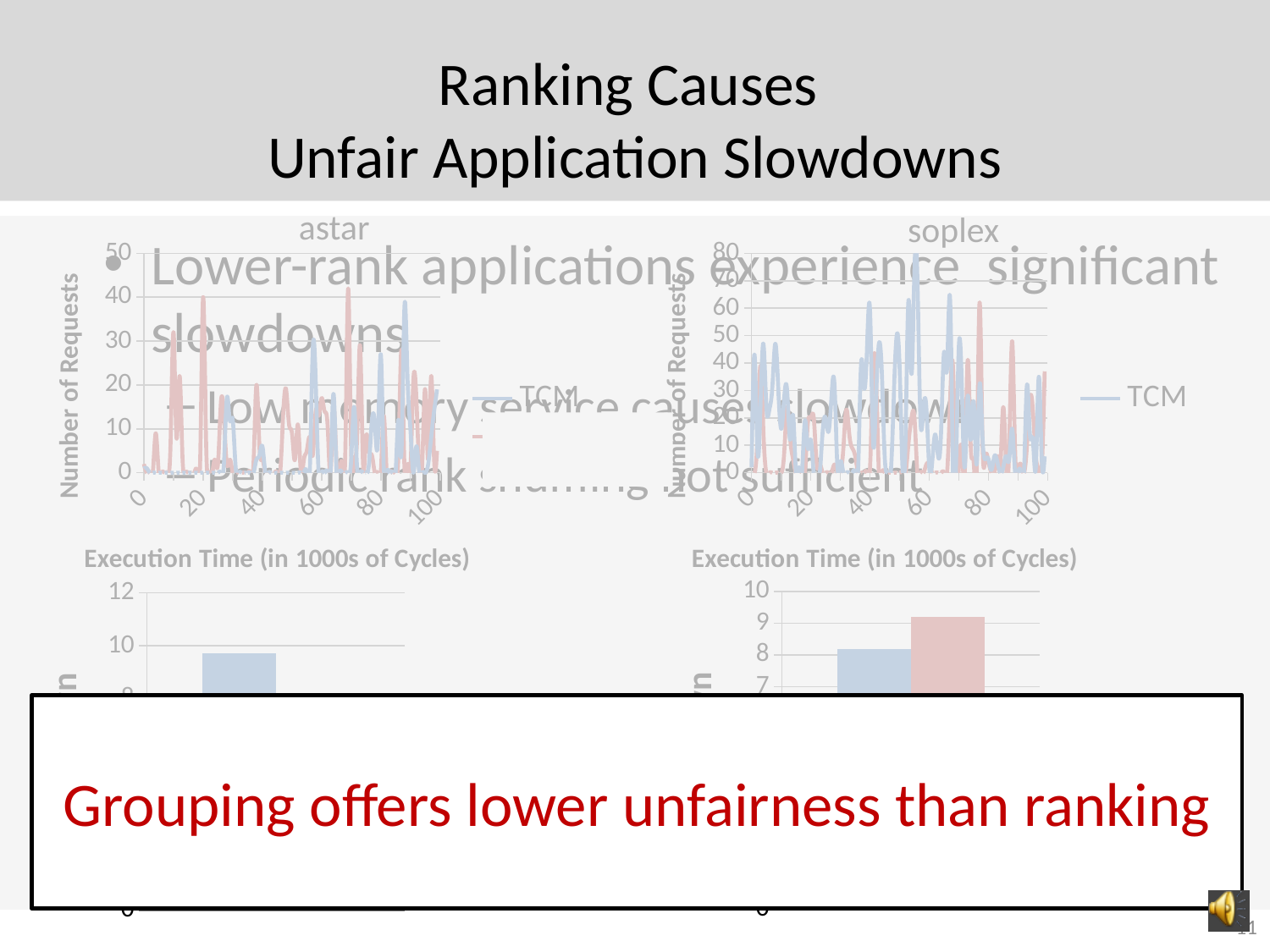
What is the y-axis title of the astar chart? Number of Requests What kind of chart is the astar chart? line chart In the bottom-right bar chart, which is taller, the blue bar or the red bar? the red bar How many lines are plotted in the soplex chart? 2 In the bottom-right bar chart, is the value of the blue bar greater or less than 7? greater In the bottom-right bar chart, is the value of the red bar greater or less than 8? greater What is the x-axis title of the soplex chart? Execution Time (in 1000s of Cycles) In the bottom-left bar chart, is the value of the blue bar greater or less than 8? greater What kind of chart is the bottom-left chart? bar chart